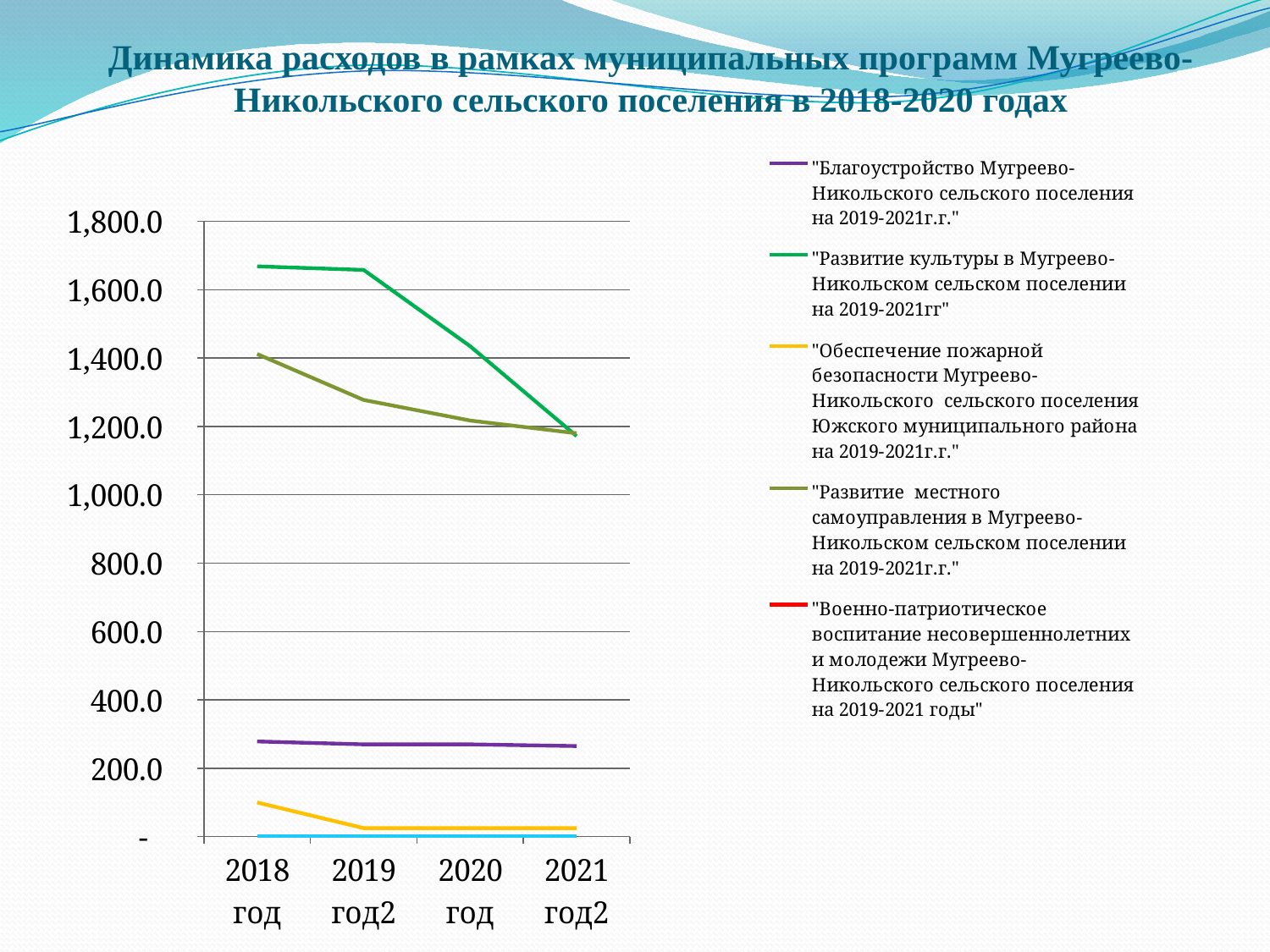
What colour is the line for "Благоустройство Мугреево-Никольского сельского поселения на 2019-2021г.г."? purple Does the line for "Развитие культуры в Мугреево-Никольском сельском поселении на 2019-2021гг" rise or fall from 2018 год to 2021 год2? fall Is the value for "Благоустройство Мугреево-Никольского сельского поселения на 2019-2021г.г." in 2018 год greater or less than 200? greater How many points are there along the x axis? 4 Is the value for "Развитие культуры в Мугреево-Никольском сельском поселении на 2019-2021гг" in 2021 год2 greater or less than 1,400? less In 2019 год2, which is larger: the value for "Развитие культуры в Мугреево-Никольском сельском поселении на 2019-2021гг" or for "Развитие местного самоуправления в Мугреево-Никольском сельском поселении на 2019-2021г.г."? "Развитие культуры в Мугреево-Никольском сельском поселении на 2019-2021гг" How many series does the legend list? 5 Which series has the highest value in 2018 год? "Развитие культуры в Мугреево-Никольском сельском поселении на 2019-2021гг" What kind of chart is shown on the slide? line chart Is the value for "Обеспечение пожарной безопасности Мугреево-Никольского сельского поселения Южского муниципального района на 2019-2021г.г." in 2018 год greater or less than 200? less